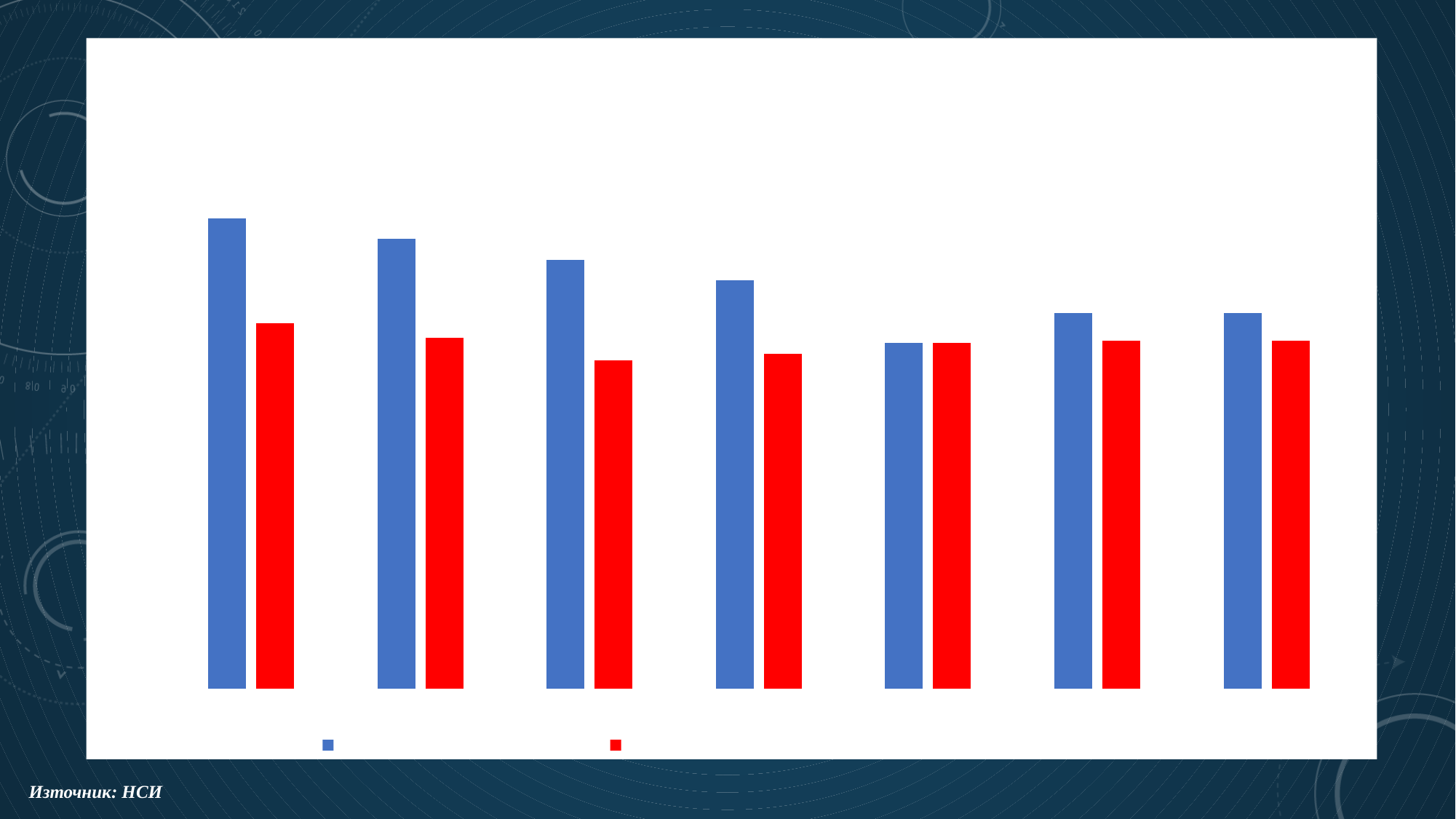
How many series does the legend list? 2 Do the blue bars rise or fall from the first group to the fourth group along the x axis? fall What colours are the two series in the chart? blue and red In the leftmost group of bars, which bar is taller, the blue one or the red one? the blue one What kind of chart is shown on the slide? bar chart Which group of bars has the tallest blue bar? the leftmost group Which group of bars has the shortest blue bar? the fifth group from the left How many groups of bars does the chart show? 7